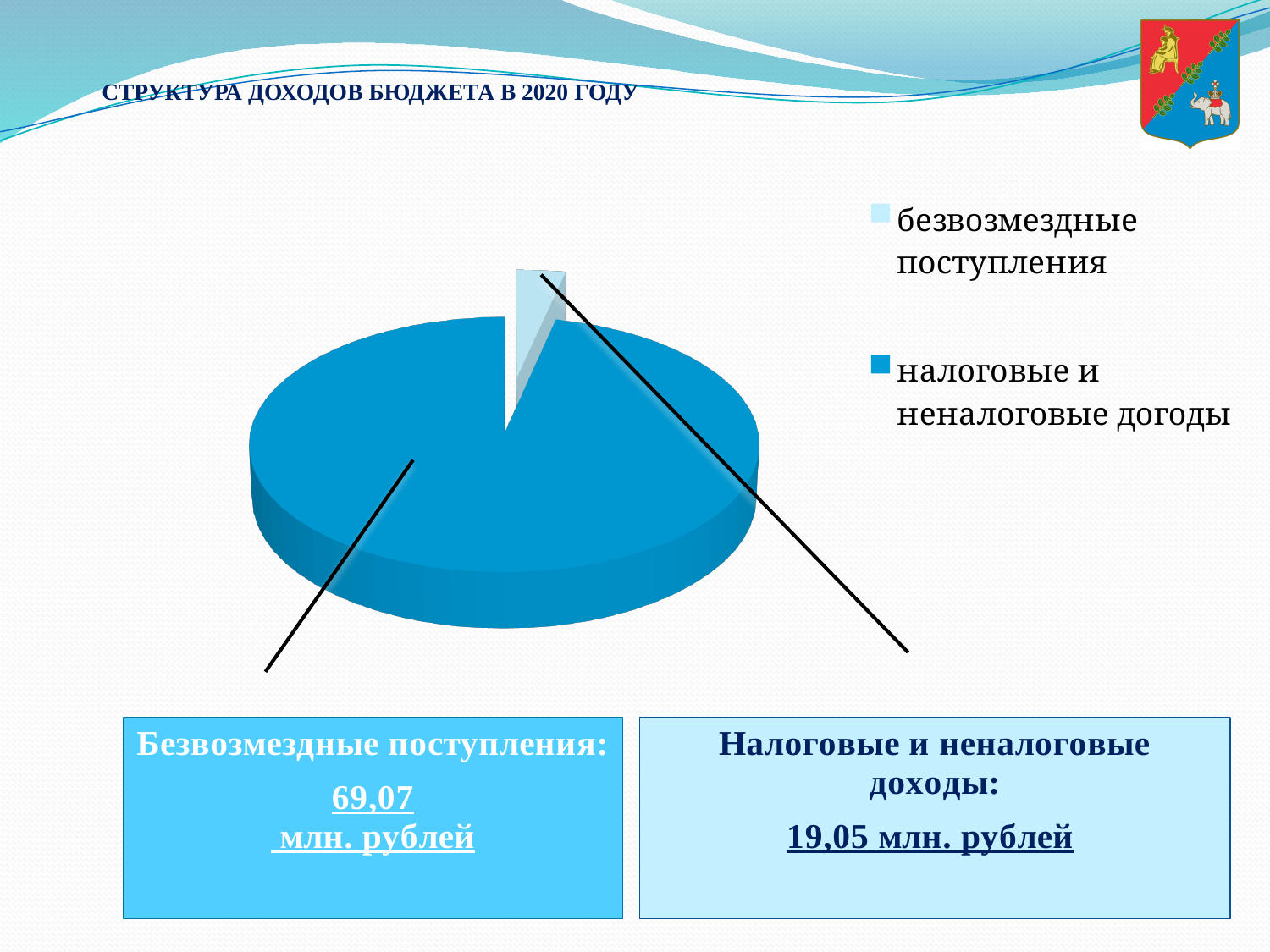
Which year does the budget income structure chart refer to? 2020 What is the value shown for Безвозмездные поступления? 69,07 млн. рублей Which colour does the legend assign to безвозмездные поступления? Light blue How many entries does the legend of the pie chart list? 2 What is the total of the two values shown for the pie chart? 88,12 млн. рублей What is the value shown for Налоговые и неналоговые доходы? 19,05 млн. рублей What is the title of the slide with the pie chart? СТРУКТУРА ДОХОДОВ БЮДЖЕТА В 2020 ГОДУ What kind of chart is shown on the slide? Pie chart How many slices does the pie chart have? 2 What is the difference between the value for Безвозмездные поступления and the value for Налоговые и неналоговые доходы? 50,02 млн. рублей